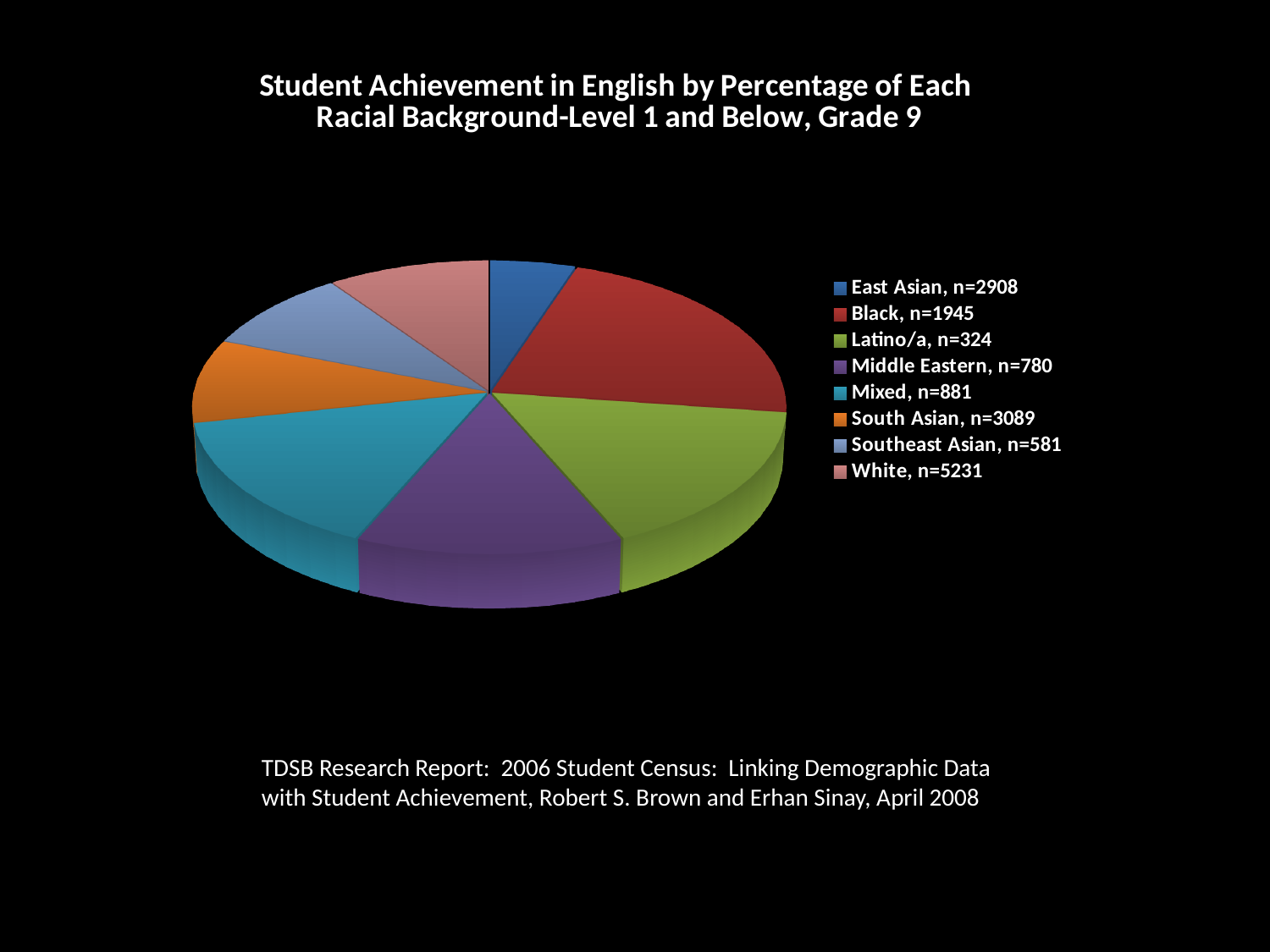
Which racial background has the smallest slice of the pie chart? East Asian Which slice is larger, Middle Eastern or South Asian? Middle Eastern Which slice is larger, Mixed or East Asian? Mixed What is the title of the chart? Student Achievement in English by Percentage of Each Racial Background-Level 1 and Below, Grade 9 Which slice is larger, Black or East Asian? Black Which racial background has the largest slice of the pie chart? Black How many slices does the pie chart have? 8 What kind of chart is shown on the slide? pie chart What n value does the legend show for White? n=5231